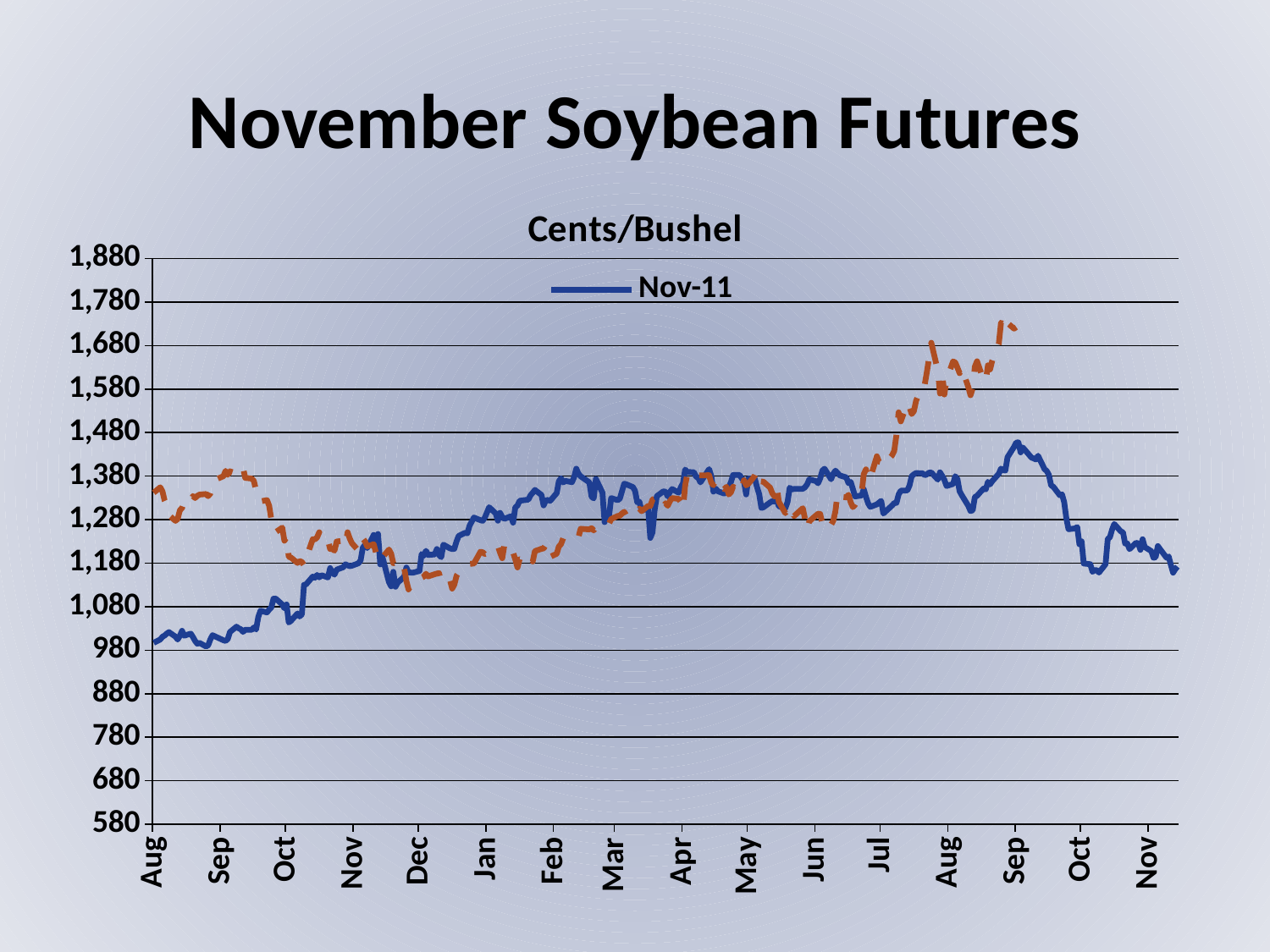
Is the highest point of the Nov-11 line, near Sep, greater or less than 1,480? less Is the Nov-11 value at the start of the chart (Aug) greater or less than 880? greater Is the highest point of the orange dashed line, near Sep, greater or less than 1,680? greater What is the name of the series listed in the chart's legend? Nov-11 Does the Nov-11 line rise or fall between Sep and Nov at the right end of the chart? fall How many series does the chart's legend list? 1 What kind of chart is shown on the slide? line chart What is the title printed above the chart's plot area? Cents/Bushel Does the Nov-11 line rise or fall between Aug and Feb? rise